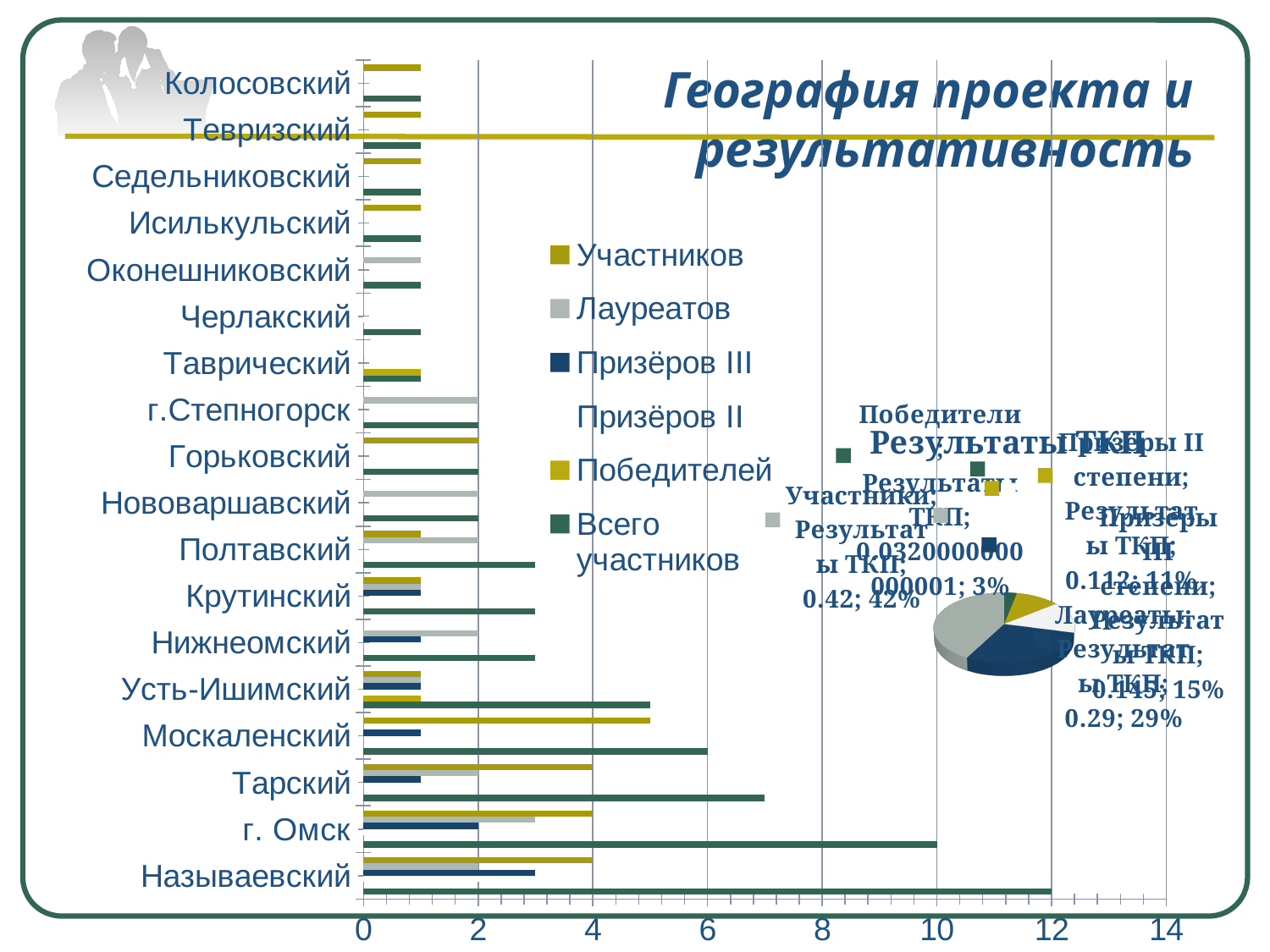
In the pie chart "Результаты ТКП", what share does the "Лауреаты" slice have? 29% What kind of chart is the large chart on the left of the slide? bar chart How many series does the legend of the bar chart list? 6 In the bar chart, is the "Всего участников" value for Тарский greater or less than 6? greater What is the title of the slide? География проекта и результативность In the bar chart, what is the difference between the "Всего участников" values for Называевский and г. Омск? 2 In the bar chart, what is the "Всего участников" value for Называевский? 12 In the bar chart, which category has the longest "Всего участников" bar? Называевский In the bar chart, what is the "Всего участников" value for г. Омск? 10 How many categories (districts) are shown on the bar chart? 18 What kind of chart is the small chart titled "Результаты ТКП" on the right? pie chart In the pie chart "Результаты ТКП", what share does the "Участники" slice have? 42%